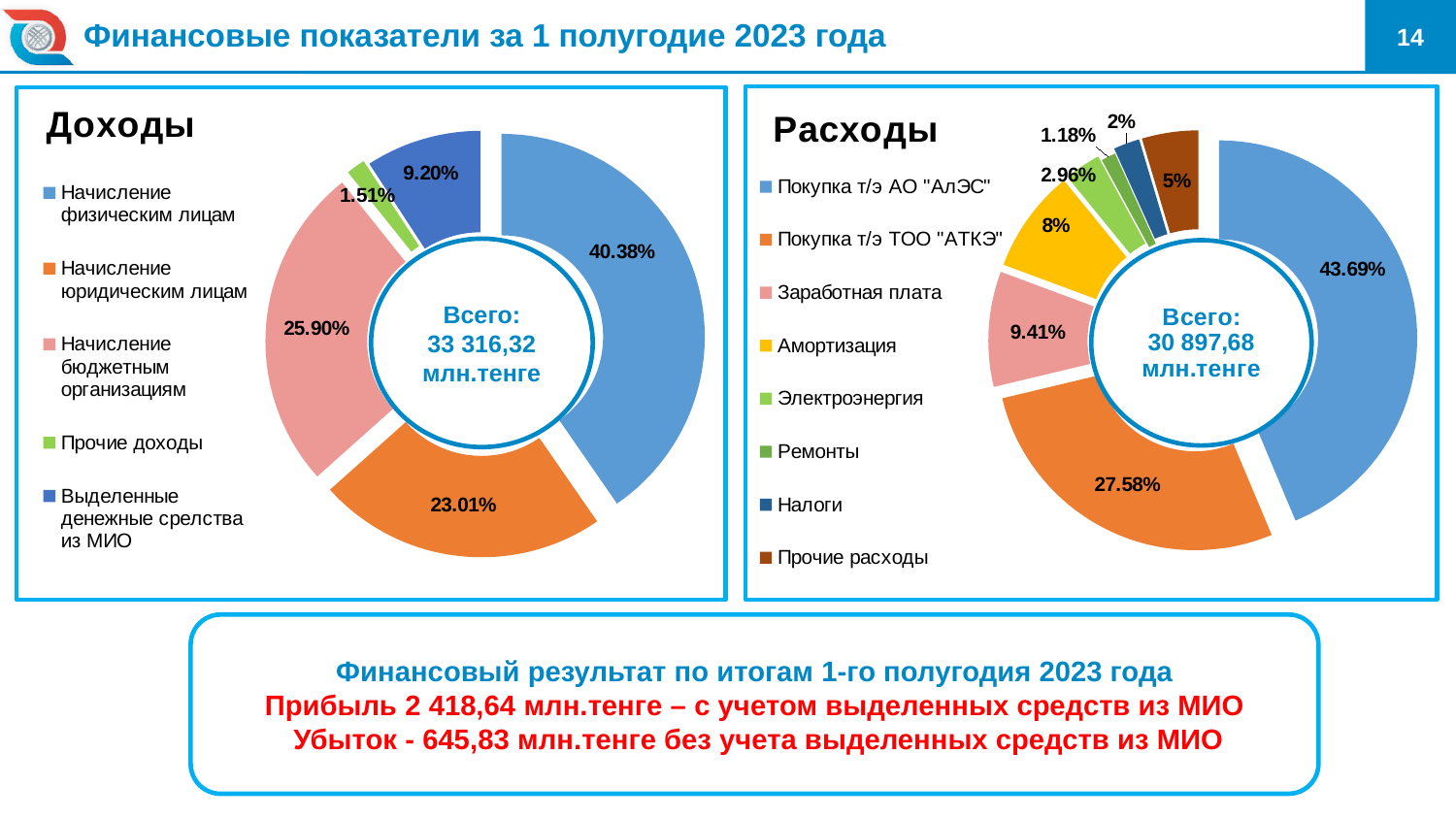
How many categories does the legend of the "Доходы" chart list? 5 What type of chart is used for "Расходы"? Doughnut (pie) chart In the "Расходы" chart, which category has the largest share? Покупка т/э АО "АлЭС" How many categories does the legend of the "Расходы" chart list? 8 In the "Доходы" chart, what share is shown for "Начисление физическим лицам"? 40.38% In the "Доходы" chart, what share is shown for "Начисление бюджетным организациям"? 25.90% In the "Расходы" chart, what share is shown for "Заработная плата"? 9.41% In the "Доходы" chart, which category has the smallest share? Прочие доходы In the "Расходы" chart, what share is shown for "Покупка т/э ТОО "АТКЭ""? 27.58% In the "Доходы" chart, what is the difference between the shares of "Начисление физическим лицам" and "Начисление юридическим лицам"? 17.37% What total value is shown in the centre of the "Доходы" chart? 33 316,32 млн.тенге In the "Расходы" chart, which is larger: the share for "Амортизация" or the share for "Прочие расходы"? Амортизация